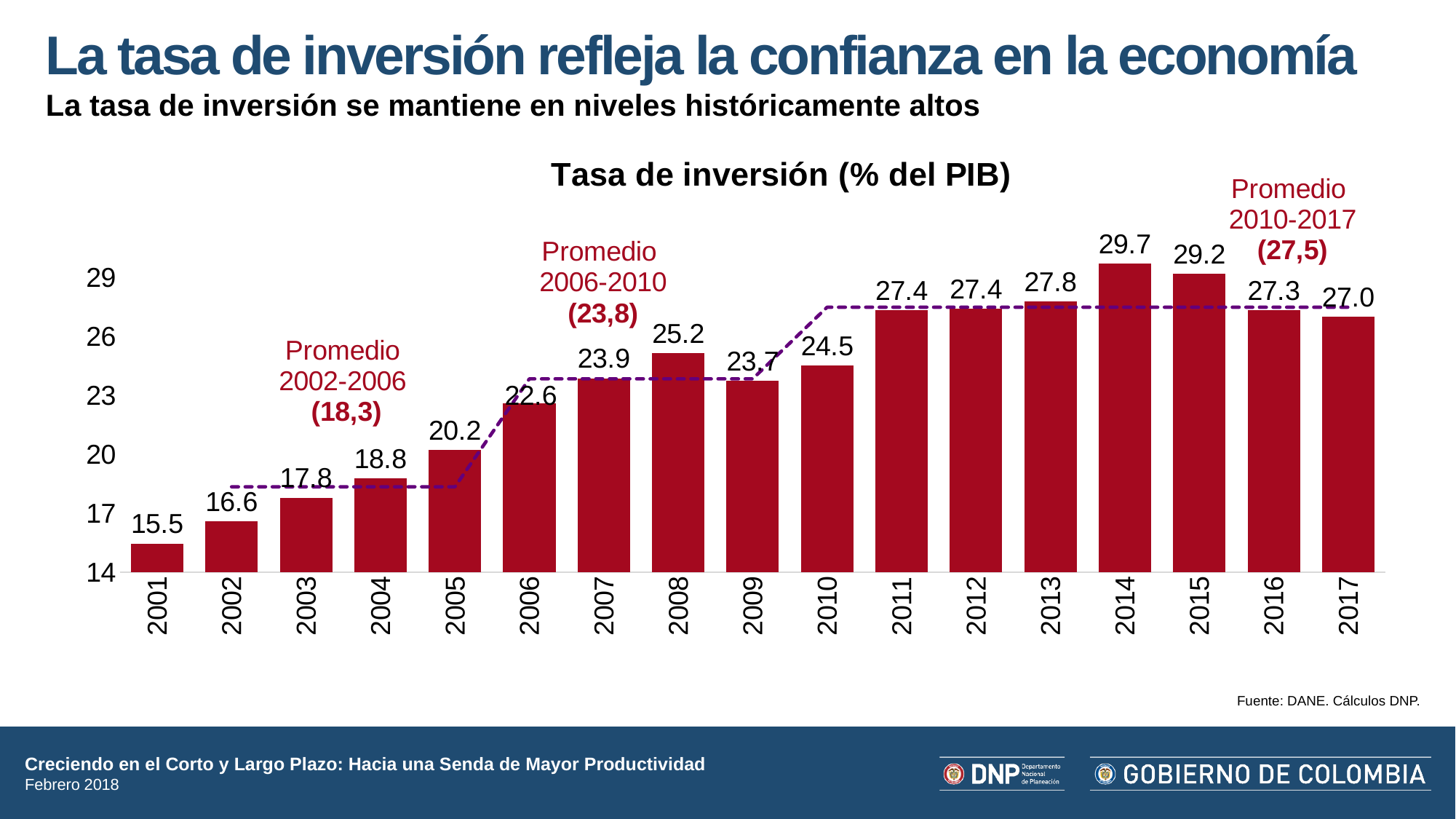
What kind of chart is this? Bar chart with a dashed line showing period averages What is the value shown for 2001? 15.5 Which is larger, the value for 2008 or the value for 2010? 2008 How many years are shown on the x axis? 17 What is the difference between the values for 2017 and 2001? 11.5 What is the value shown for 2009? 23.7 Which year has the highest investment rate? 2014 Is the value for 2005 greater or less than 20? greater Do the values generally rise or fall from 2001 to 2014? Rise Which year has the lowest investment rate? 2001 What is the average (Promedio) shown for 2010-2017? 27,5 What is the investment rate (% of GDP) shown for 2014? 29.7